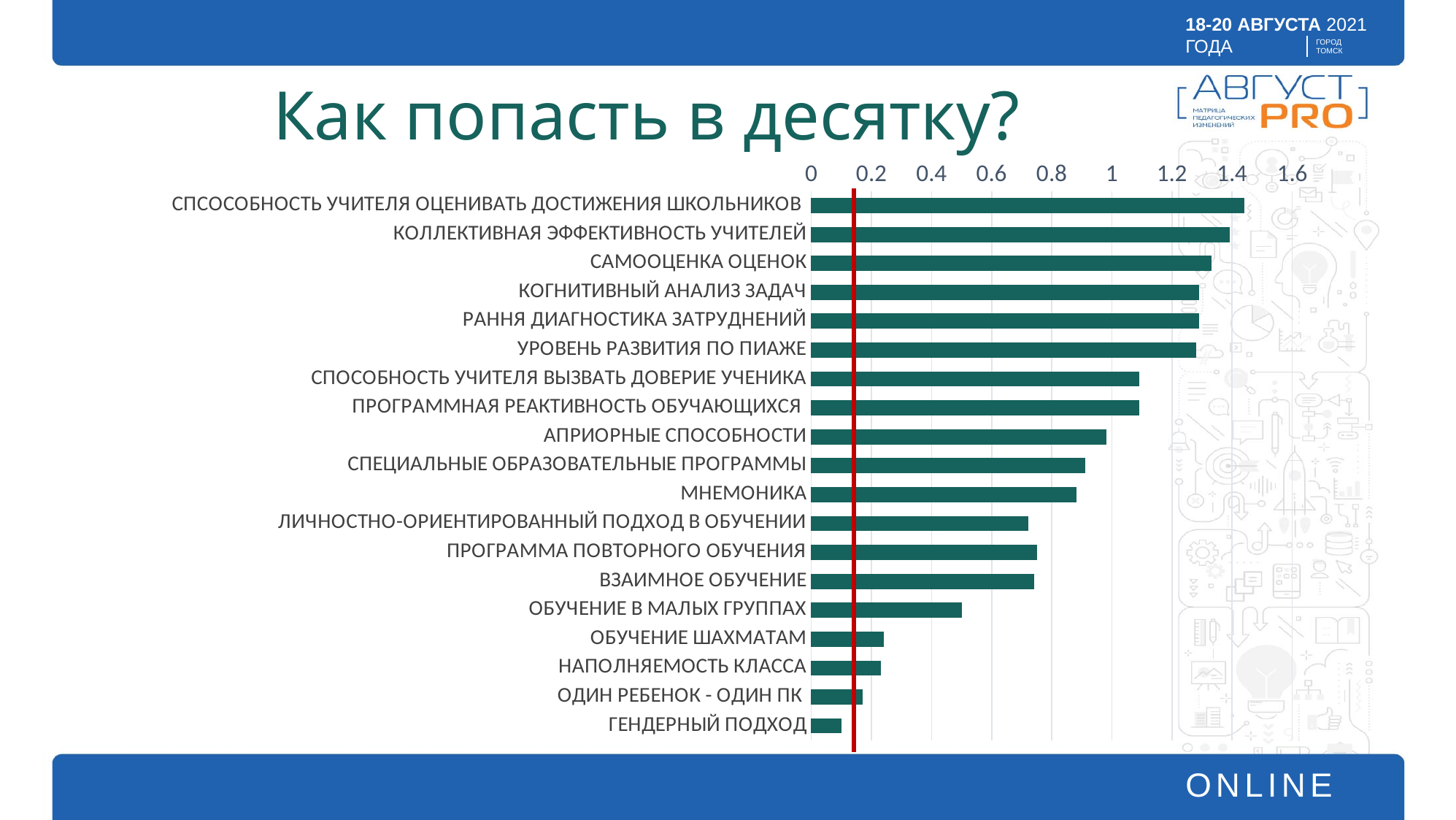
Do the bar values increase or decrease going from the top category to the bottom category? decrease Is the value for ОБУЧЕНИЕ В МАЛЫХ ГРУППАХ greater or less than 0.4? greater How many categories are plotted in the chart? 19 Which has the larger value: ОБУЧЕНИЕ В МАЛЫХ ГРУППАХ or ОБУЧЕНИЕ ШАХМАТАМ? ОБУЧЕНИЕ В МАЛЫХ ГРУППАХ Which category has the highest value in the chart? СПСОСОБНОСТЬ УЧИТЕЛЯ ОЦЕНИВАТЬ ДОСТИЖЕНИЯ ШКОЛЬНИКОВ Is the value for МНЕМОНИКА greater or less than 0.8? greater What kind of chart is shown on the slide? bar chart Is the value for СПОСОБНОСТЬ УЧИТЕЛЯ ОЦЕНИВАТЬ ДОСТИЖЕНИЯ ШКОЛЬНИКОВ greater or less than 1.4? greater What is the title of the slide containing the chart? Как попасть в десятку? Which category has the lowest value in the chart? ГЕНДЕРНЫЙ ПОДХОД